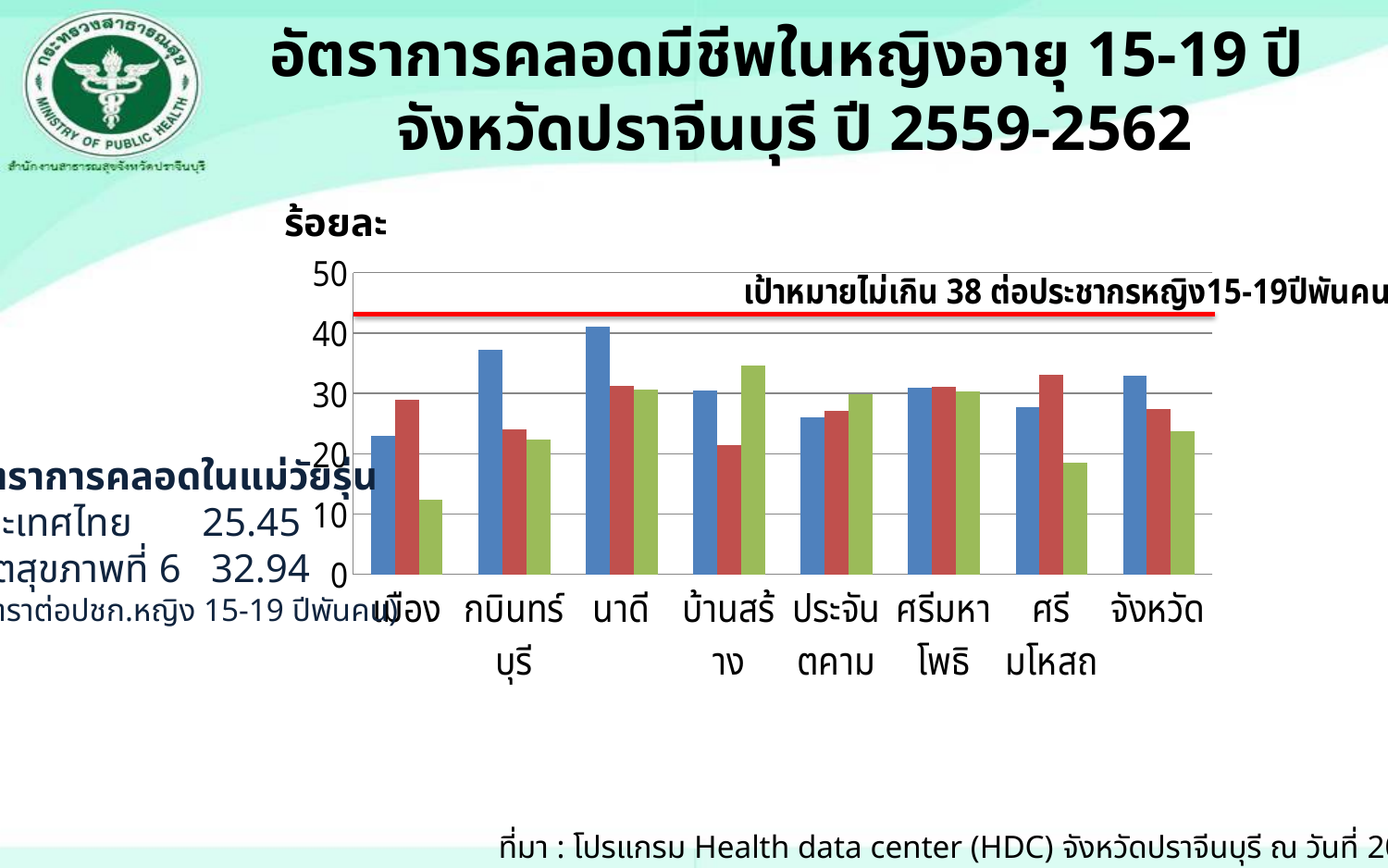
Which category has the shortest red bar? บ้านสร้าง For บ้านสร้าง, which is larger: the red bar or the green bar? the green bar What is the target value stated in the text above the red line on the chart? ไม่เกิน 38 ต่อประชากรหญิง15-19ปีพันคน What kind of chart is shown on the slide? bar chart For เมือง, which is larger: the blue bar or the green bar? the blue bar Is the green bar for ศรีมโหสถ greater or less than 20? less Which category has the tallest blue bar? นาดี How many categories are shown along the x axis of the chart? 8 Which category has the shortest green bar? เมือง How many bars are plotted for each category in the chart? 3 Is the blue bar for กบินทร์บุรี greater or less than 30? greater Which category has the tallest green bar? บ้านสร้าง